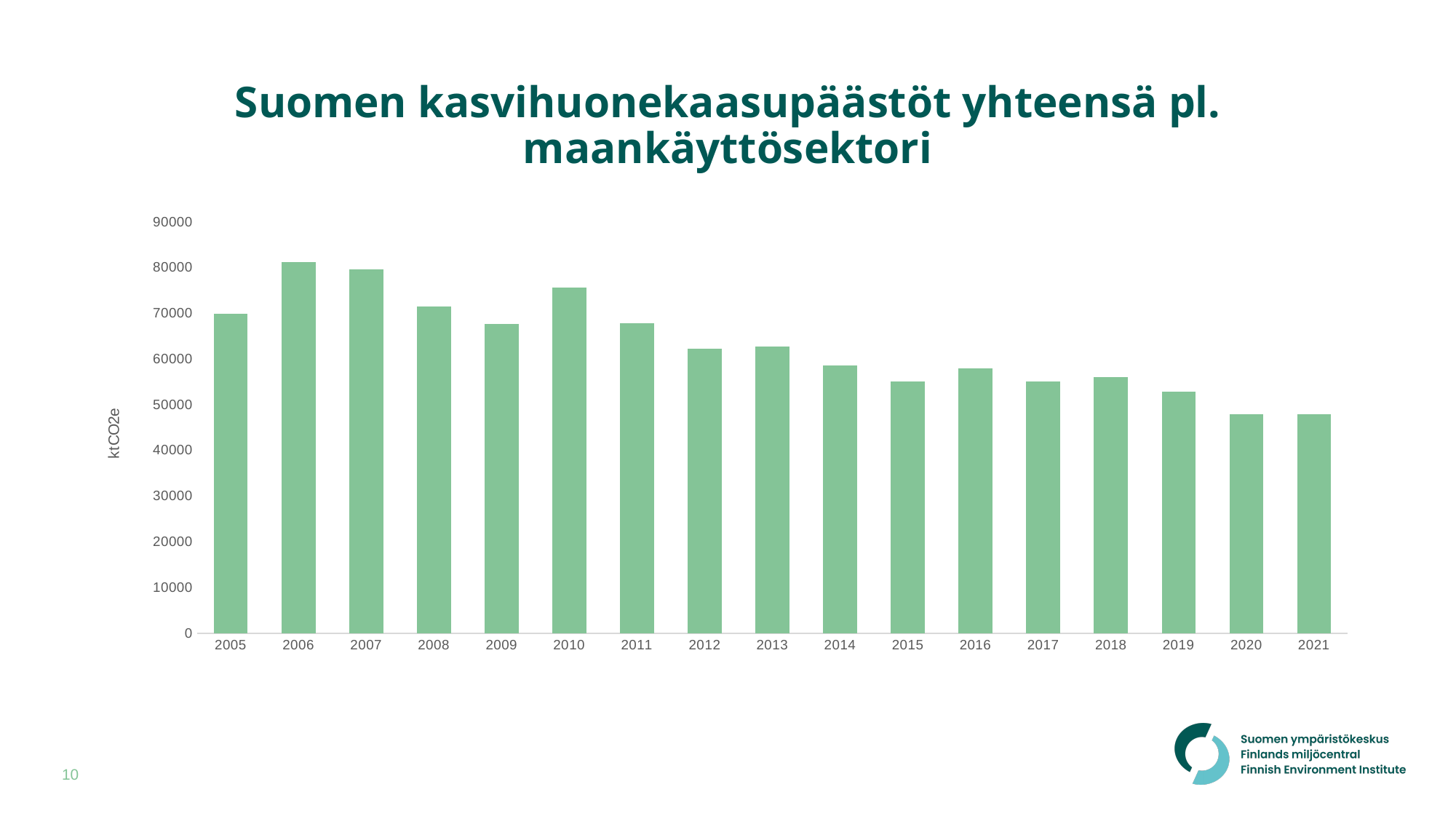
What kind of chart is shown on the slide? bar chart Which is larger, the value for 2007 or the value for 2008? 2007 Is the value for 2012 greater or less than 60000? greater Which is larger, the value for 2010 or the value for 2011? 2010 Do the values generally rise or fall from 2005 to 2021? fall What unit is shown on the y axis of the chart? ktCO2e Is the value for 2015 greater or less than 60000? less How many years are shown on the x axis of the chart? 17 Is the value for 2020 greater or less than 50000? less Which year has the highest emissions in the chart? 2006